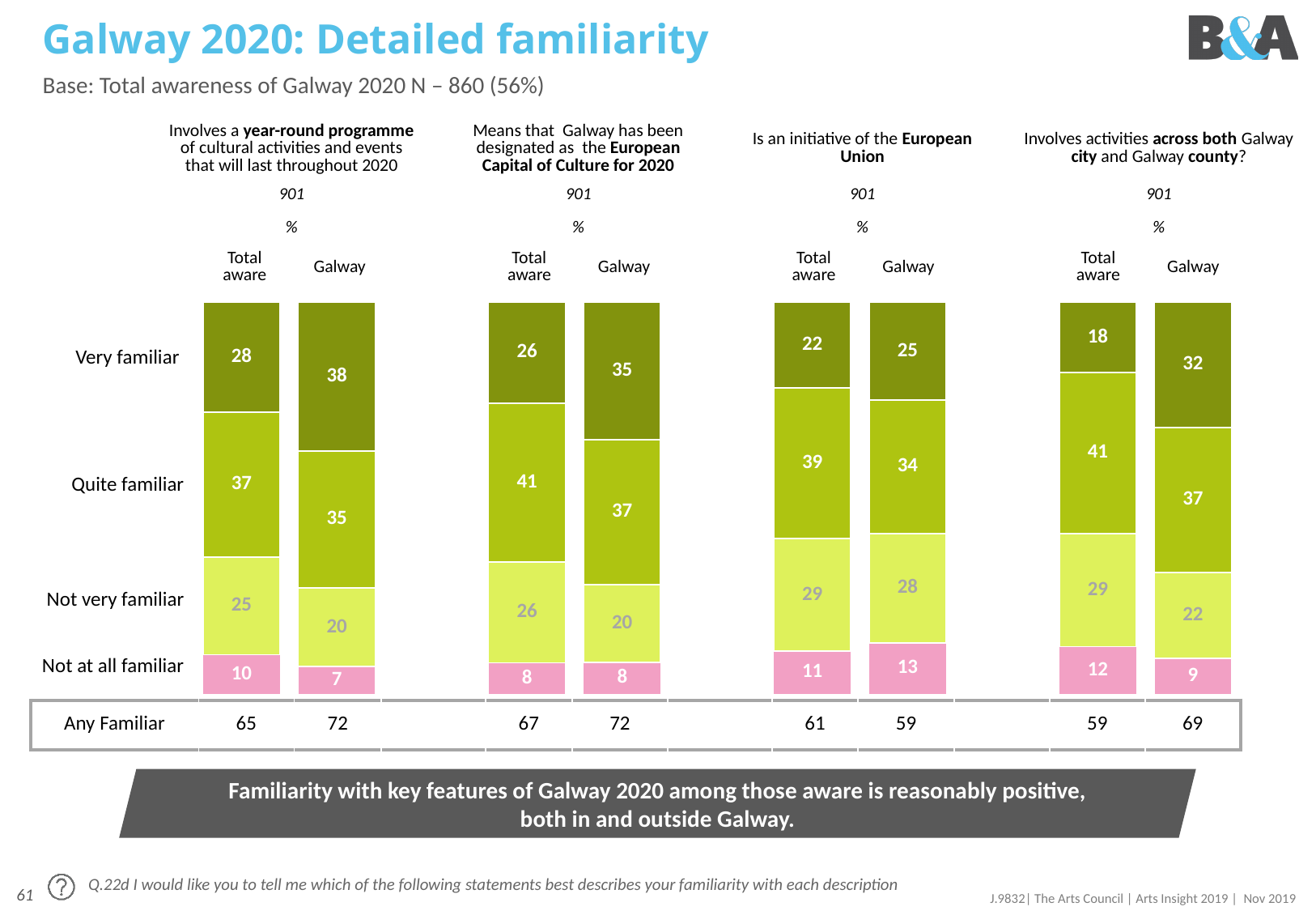
In the 'across both Galway city and Galway county' chart, what is the 'Any Familiar' value for Galway? 69 How many familiarity categories are stacked in each bar? 4 In the 'year-round programme' chart, what percentage of the Galway bar is 'Very familiar'? 38 In the 'European Capital of Culture for 2020' chart, what is the 'Quite familiar' value for Total aware? 41 Across the four charts, which statement has the highest 'Very familiar' value for Galway? Involves a year-round programme of cultural activities and events that will last throughout 2020 Across the four charts, which statement has the lowest 'Very familiar' value for Total aware? Involves activities across both Galway city and Galway county In the 'initiative of the European Union' chart, what is the 'Not at all familiar' value for Galway? 13 In the 'across both Galway city and Galway county' chart, what is the 'Very familiar' value for Total aware? 18 In the 'European Capital of Culture for 2020' chart, what is the total of the Galway bar's 'Very familiar' and 'Quite familiar' segments? 72 In the 'initiative of the European Union' chart, which bar has the higher 'Quite familiar' value, Total aware or Galway? Total aware What type of chart is used on this slide? Stacked bar chart In the 'year-round programme' chart, what is the difference between the 'Very familiar' values for Galway and Total aware? 10